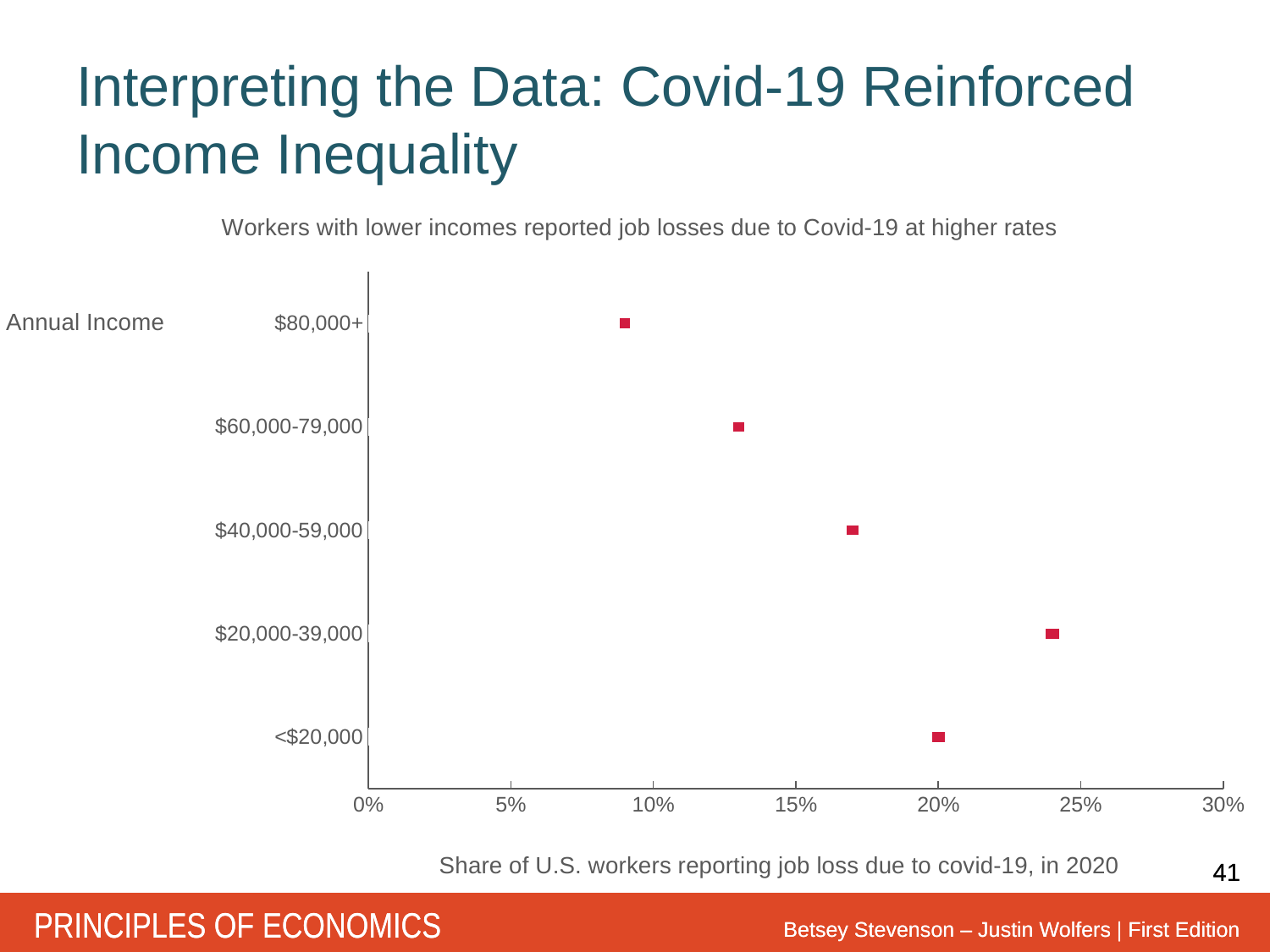
Which income group has the lowest share of workers reporting job loss due to Covid-19? $80,000+ Is the share of workers reporting job loss for the $20,000-39,000 group greater or less than 20%? greater Which group has a larger share of workers reporting job loss: $40,000-59,000 or $60,000-79,000? $40,000-59,000 Is the share of workers reporting job loss for the $40,000-59,000 group greater or less than 15%? greater Is the share of workers reporting job loss for the $60,000-79,000 group greater or less than 15%? less What is the title of the chart? Workers with lower incomes reported job losses due to Covid-19 at higher rates How many income groups are plotted on the chart? 5 Which income group has the highest share of workers reporting job loss due to Covid-19? $20,000-39,000 What is the label of the horizontal axis of the chart? Share of U.S. workers reporting job loss due to covid-19, in 2020 What kind of chart is shown on the slide? Scatter (dot) chart Which group has a larger share of workers reporting job loss: $20,000-39,000 or <$20,000? $20,000-39,000